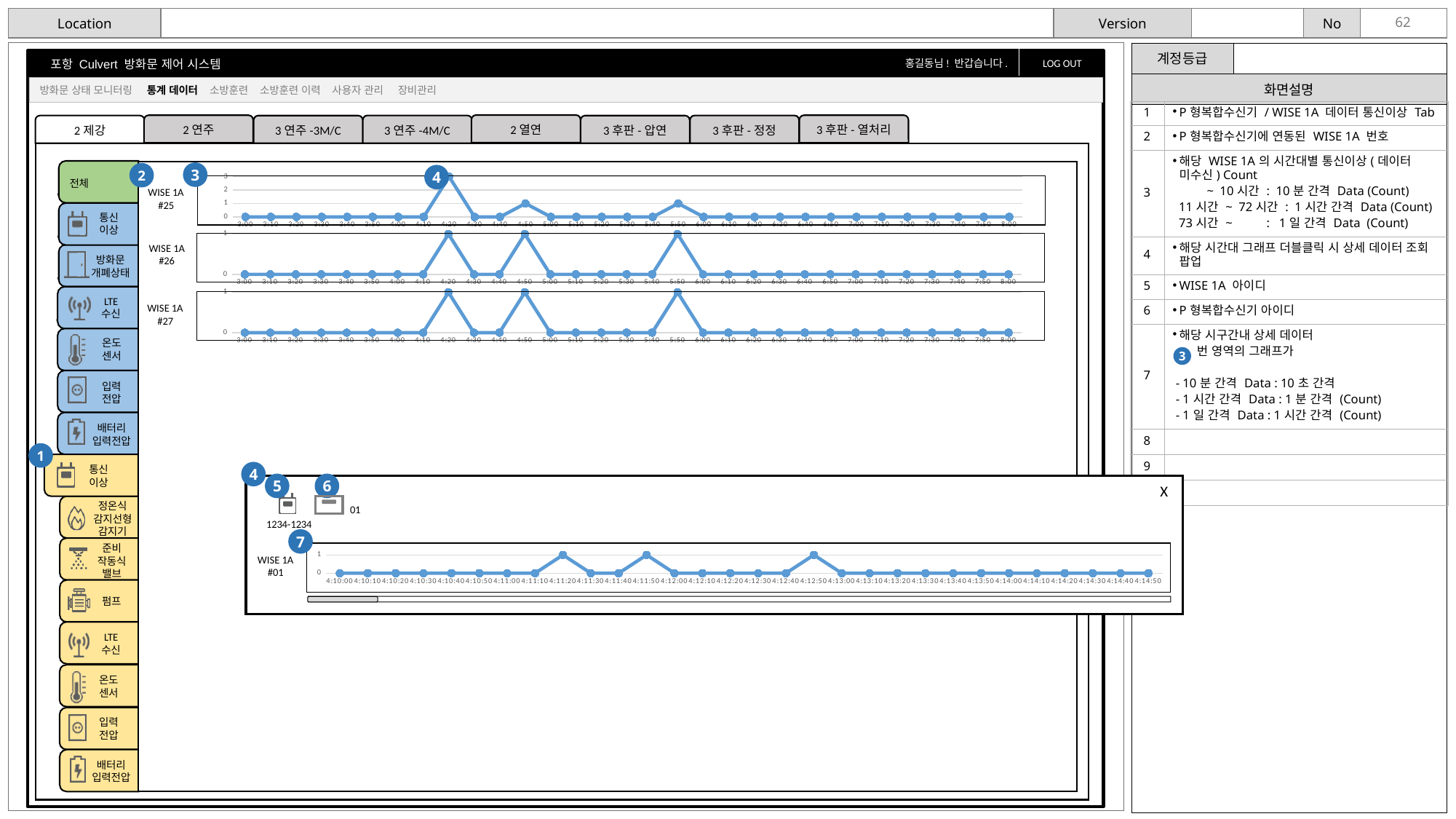
In the WISE 1A #26 chart, what is the value at 6:00? 0 In the WISE 1A #01 chart in the popup window, what is the value at 4:11:20? 1 In the WISE 1A #27 chart, what is the value at 5:50? 1 In the WISE 1A #27 chart, what is the value at 5:00? 0 In the WISE 1A #25 chart, what is the value at 3:00? 0 In the WISE 1A #25 chart, what is the value at 4:20? 3 In the WISE 1A #01 chart in the popup window, what is the value at 4:10:00? 0 In the WISE 1A #26 chart, what is the value at 4:20? 1 What is the first and last time label on the x axis of the WISE 1A #25 chart? 3:00 and 8:00 In the WISE 1A #25 chart, which is larger, the value at 4:20 or the value at 4:50? 4:20 What kind of chart is the WISE 1A #25 chart? line chart In the WISE 1A #25 chart, at which time does the line reach its highest value? 4:20